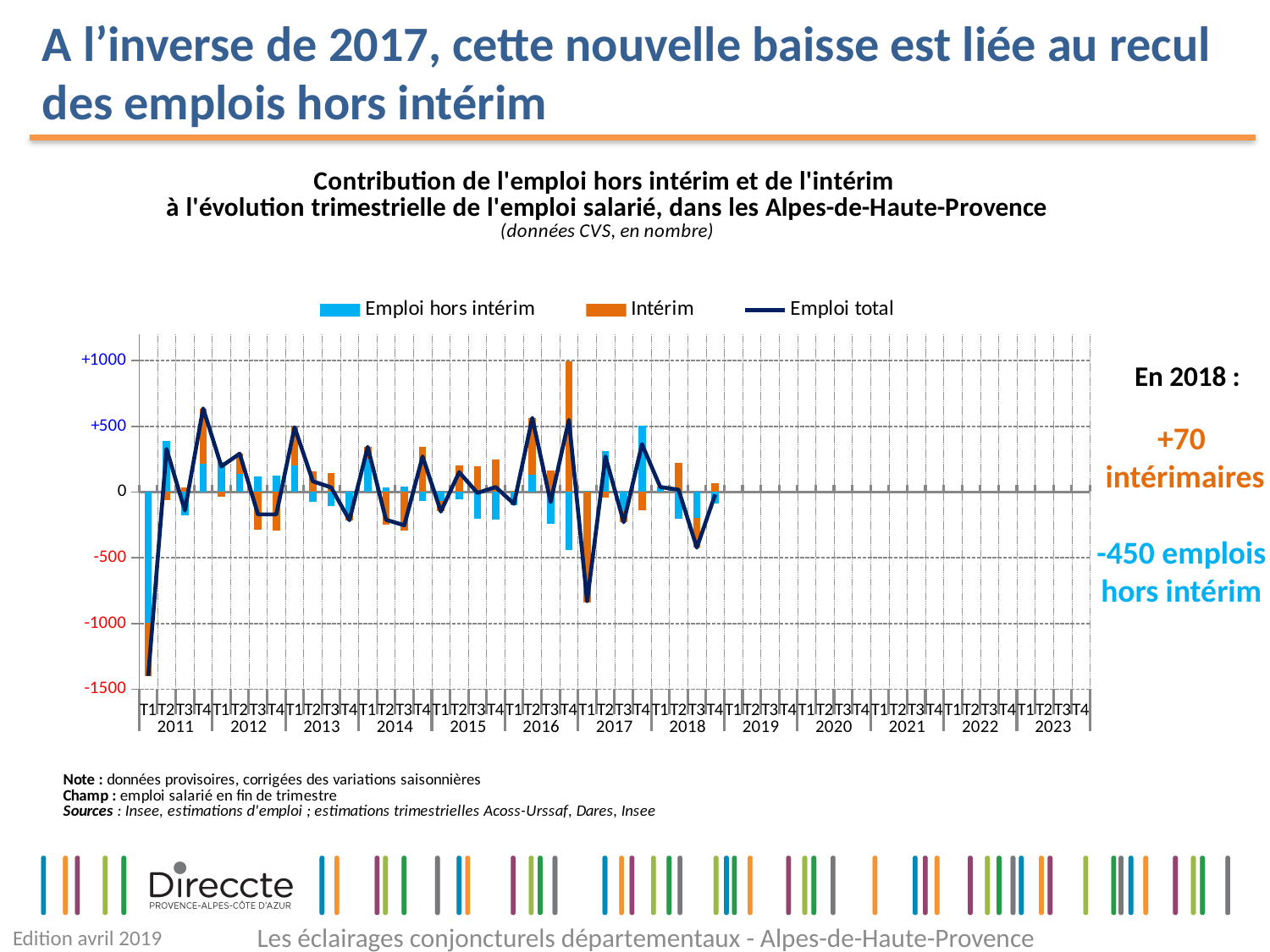
What kind of chart is shown on the slide? A combined bar and line chart In which quarter does the Emploi total line reach its lowest value? T1 2011 Is the value of Emploi total in T1 2017 greater or less than -500? less Is the value of Intérim in T4 2016 greater or less than +500? greater In which quarter is the Intérim bar the highest? T4 2016 What colour are the bars for the Intérim series? Orange How many series does the chart legend list? 3 Which series is drawn as a line rather than bars? Emploi total Is the value of Emploi total in T1 2011 greater or less than -1000? less How many years are labelled along the x axis of the chart? 13